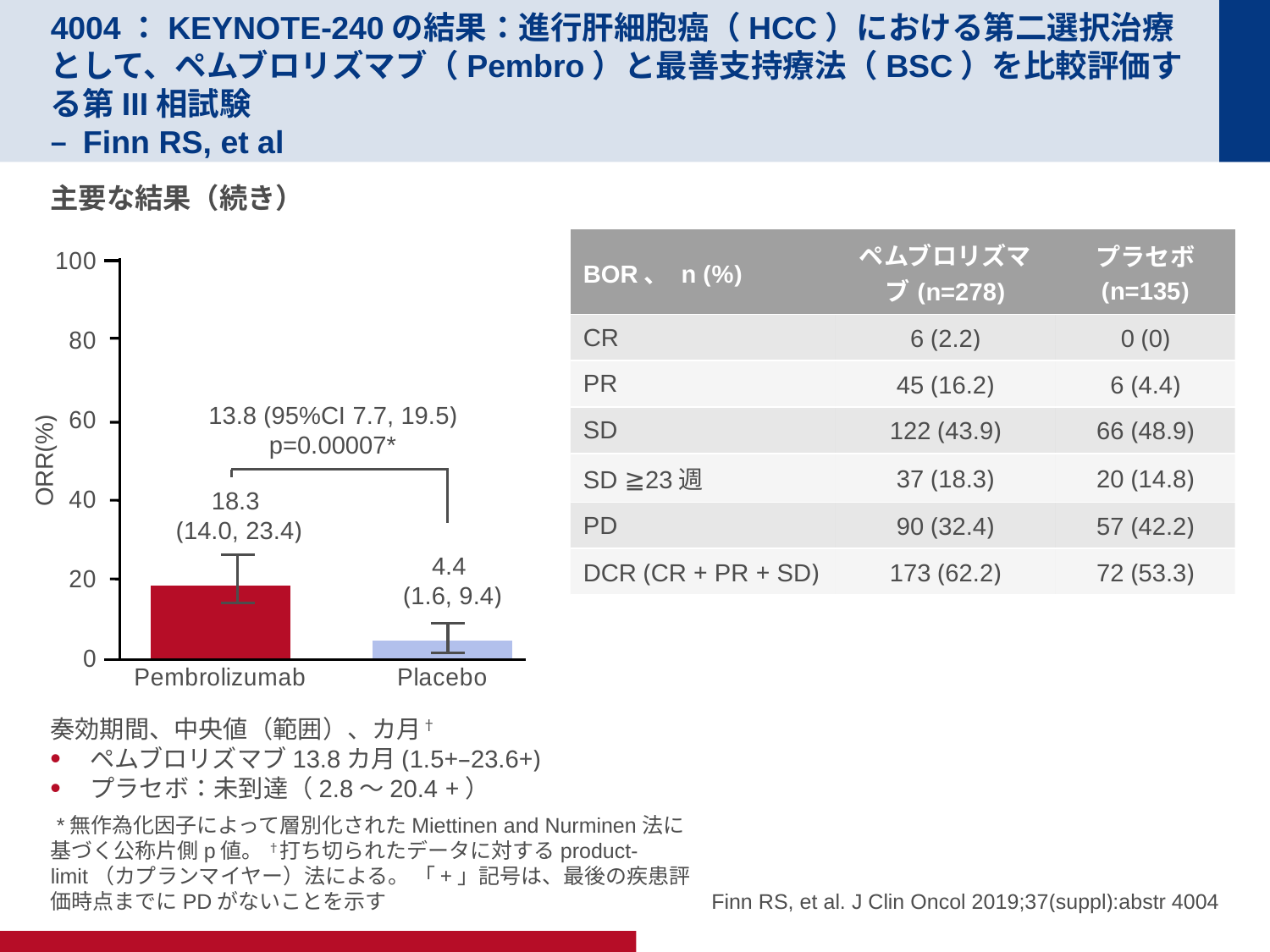
What is the ORR (%) value for Pembrolizumab in the bar chart? 18.3 Is the ORR for Pembrolizumab larger or smaller than the ORR for Placebo? larger What kind of chart is shown on the slide? bar chart How many categories are shown on the x axis of the bar chart? 2 Is the ORR value for Pembrolizumab greater or less than 20? less What is the ORR (%) value for Placebo in the bar chart? 4.4 What is the difference in ORR (%) between Pembrolizumab and Placebo in the bar chart? 13.8 Is the ORR value for Placebo greater or less than 20? less Which category has the higher ORR in the bar chart? Pembrolizumab What is the label of the y axis of the bar chart? ORR(%) Which category has the lower ORR in the bar chart? Placebo What is the 95% confidence interval printed for the Placebo bar? (1.6, 9.4)